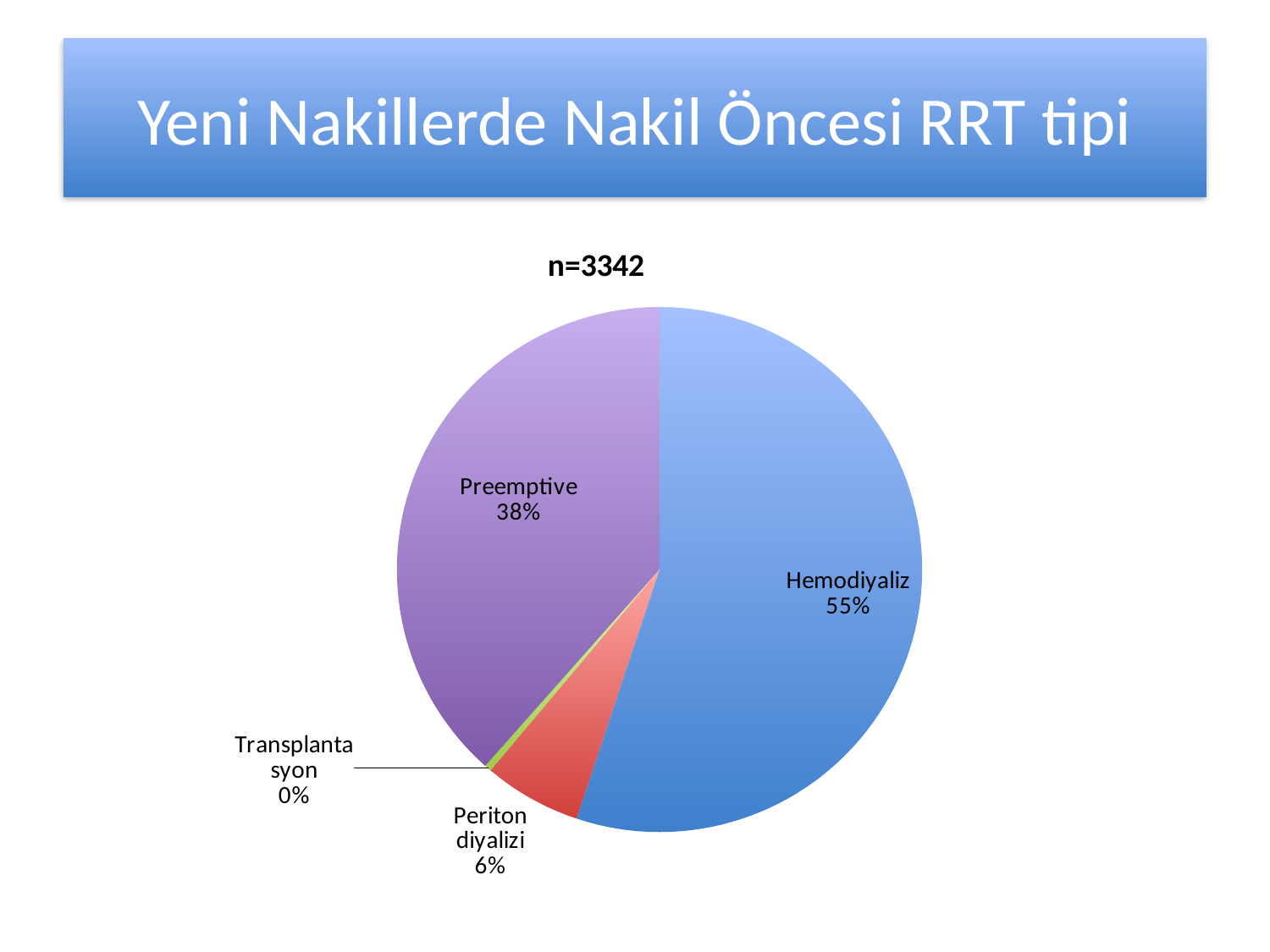
Which category has the largest slice of the pie? Hemodiyaliz What percentage is shown for Transplantasyon? 0% What type of chart is shown on the slide? pie chart What share of the pie does Hemodiyaliz represent? 55% Which is larger, the share for Hemodiyaliz or the share for Preemptive? Hemodiyaliz What is the difference in percentage points between Hemodiyaliz and Preemptive? 17 How many categories are shown in the pie chart? 4 What is the difference in percentage points between Preemptive and Periton diyalizi? 32 What is the chart title shown above the pie? n=3342 Which category has the smallest slice of the pie? Transplantasyon What share of the pie does Preemptive represent? 38% What share of the pie does Periton diyalizi represent? 6%